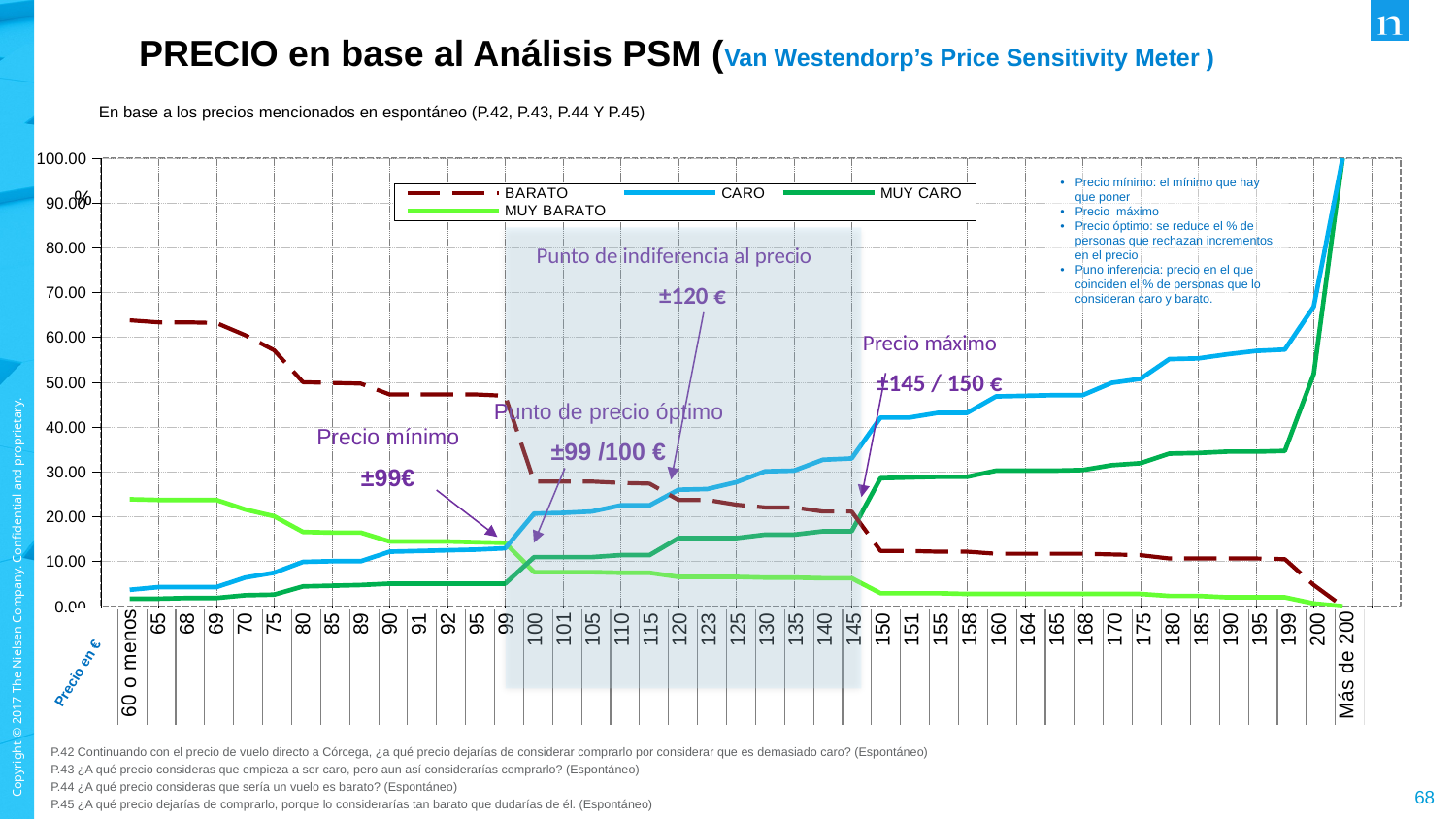
Is the value of the BARATO series at '60 o menos' greater or less than 60? greater Is the value of the CARO series at 'Más de 200' greater or less than 90? greater At '60 o menos', which series has the higher value, BARATO or CARO? BARATO According to the annotation on the chart, what price is marked as the 'Punto de indiferencia al precio'? ±120 € Does the CARO series generally rise or fall as the price increases along the x axis? rise What kind of chart is shown on the slide? line chart Does the BARATO series generally rise or fall as the price increases along the x axis? fall How many series does the chart legend list? 4 Is the value of the BARATO series at 200 greater or less than 10? less Which series is plotted with a dashed dark red line? BARATO At 200, which series has the higher value, CARO or BARATO? CARO